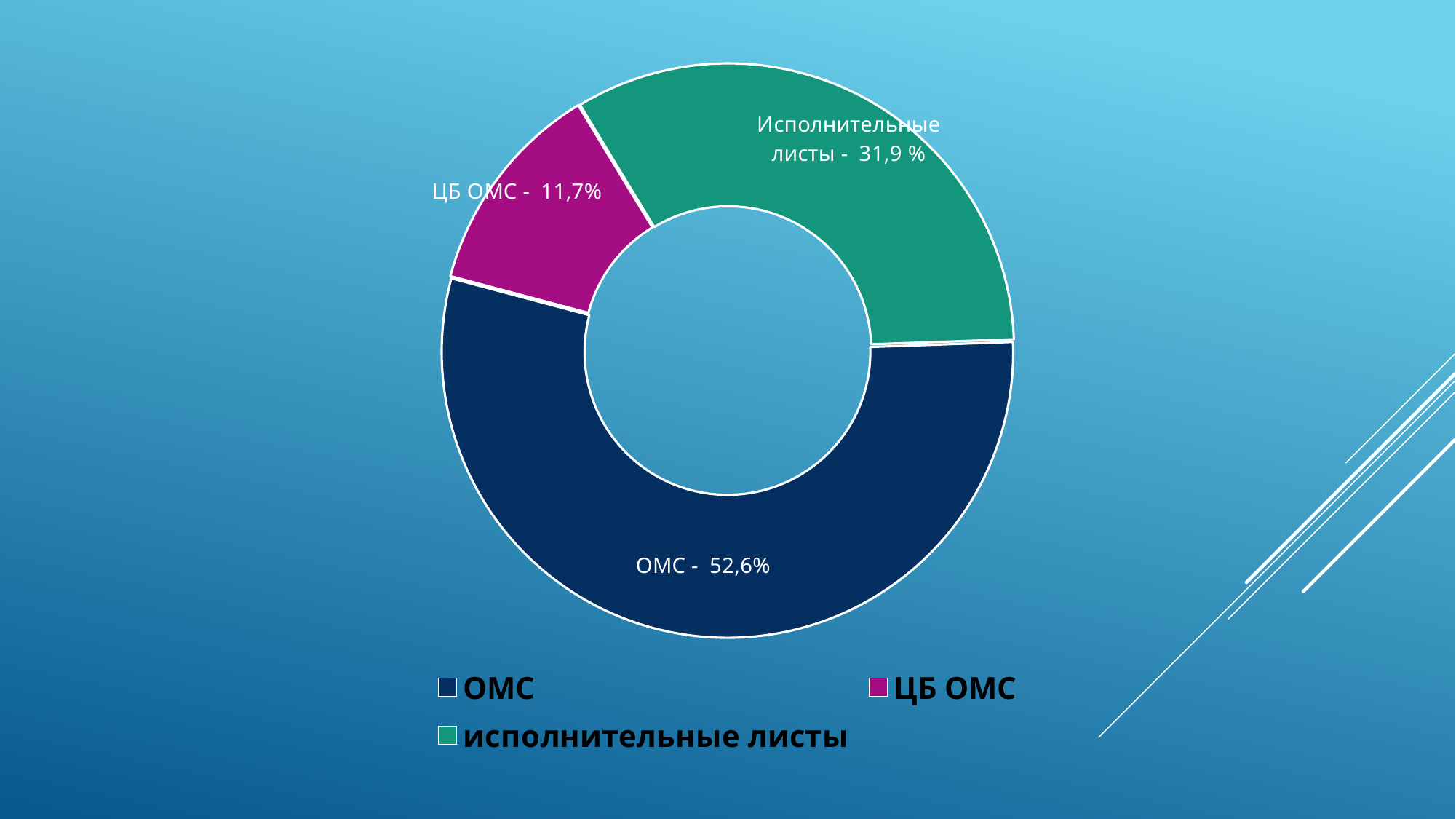
Which category has the largest share of the chart? ОМС What colour is the ЦБ ОМС slice? Magenta (purple-pink) How many entries does the legend list? 3 Which category has the smallest share of the chart? ЦБ ОМС What share is shown for ЦБ ОМС? 11,7% What kind of chart is shown on the slide? Doughnut (pie) chart What share is shown for ОМС? 52,6% What share is shown for Исполнительные листы? 31,9 % How many slices does the chart have? 3 Which is larger, the share for ЦБ ОМС or the share for Исполнительные листы? Исполнительные листы What is the difference in percentage points between Исполнительные листы and ЦБ ОМС? 20,2 What is the difference in percentage points between ОМС and Исполнительные листы? 20,7